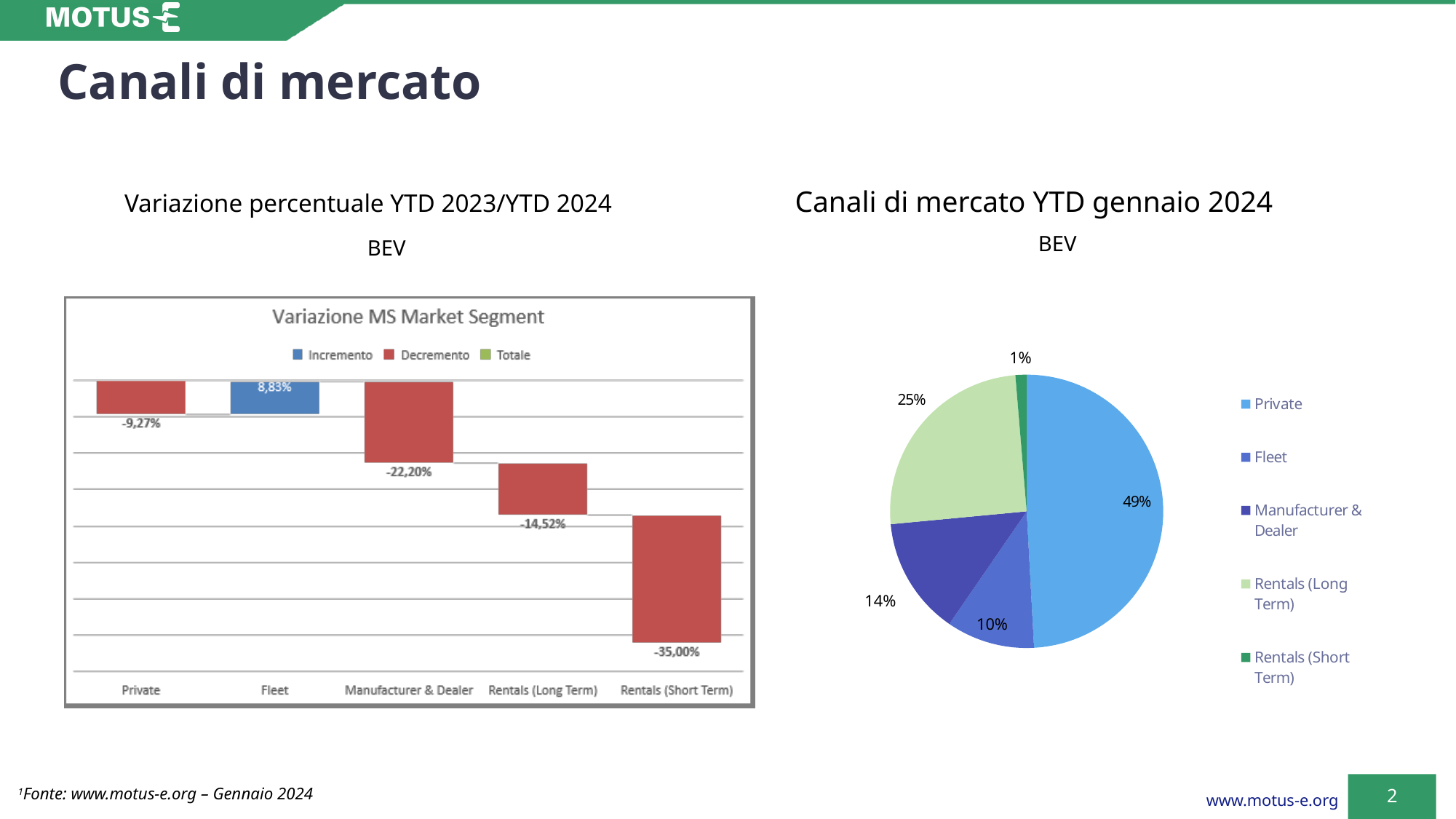
In the 'Canali di mercato YTD gennaio 2024' pie chart, which slice is the smallest? Rentals (Short Term) In the 'Variazione MS Market Segment' chart, what is the value for Manufacturer & Dealer? -22,20% In the 'Canali di mercato YTD gennaio 2024' pie chart, what share does Rentals (Long Term) have? 25% In the 'Canali di mercato YTD gennaio 2024' pie chart, what share does Private have? 49% In the 'Variazione MS Market Segment' chart, which category has the highest value? Fleet In the 'Variazione MS Market Segment' chart, what is the value for Rentals (Short Term)? -35,00% In the 'Canali di mercato YTD gennaio 2024' pie chart, what is the difference between the Manufacturer & Dealer share and the Fleet share? 4% In the 'Variazione MS Market Segment' chart, what is the value for Fleet? 8,83% In the 'Variazione MS Market Segment' chart, how many entries does the legend list? 3 What kind of chart is the 'Variazione MS Market Segment' chart? Bar chart In the 'Variazione MS Market Segment' chart, how many categories are shown on the x axis? 5 In the 'Variazione MS Market Segment' chart, which category has the lowest value? Rentals (Short Term)